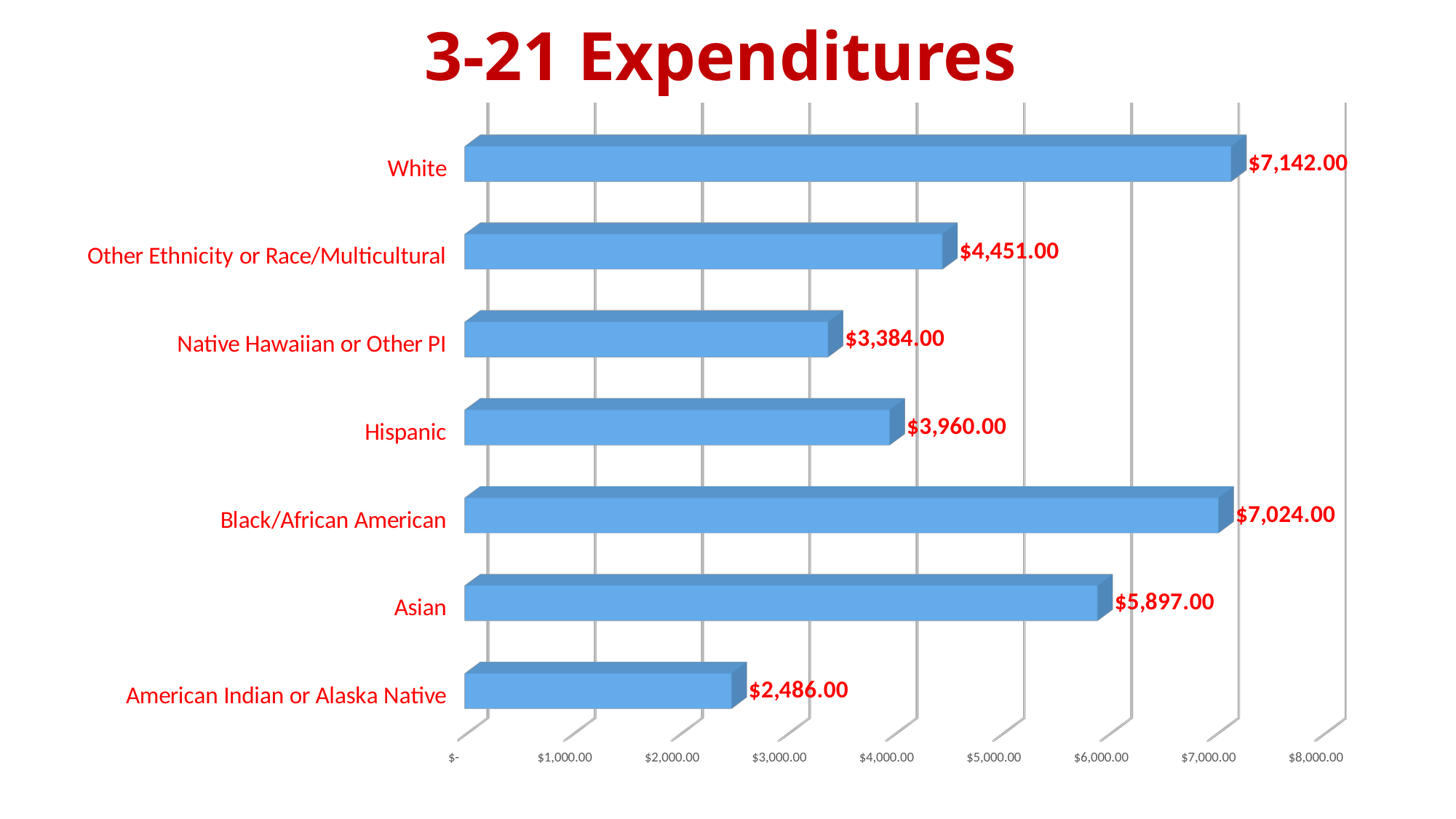
Which category has the lowest value? American Indian or Alaska Native What is the title of the chart? 3-21 Expenditures What is the difference between the values for Asian and Hispanic? $1,937.00 Which is larger, the value for Other Ethnicity or Race/Multicultural or the value for Hispanic? Other Ethnicity or Race/Multicultural What is the value for Hispanic? $3,960.00 What kind of chart is this? Bar chart What is the value for Native Hawaiian or Other PI? $3,384.00 How many categories are shown in the chart? 7 Which category has the highest value? White What is the value for American Indian or Alaska Native? $2,486.00 What is the value for White? $7,142.00 What is the difference between the values for White and Black/African American? $118.00